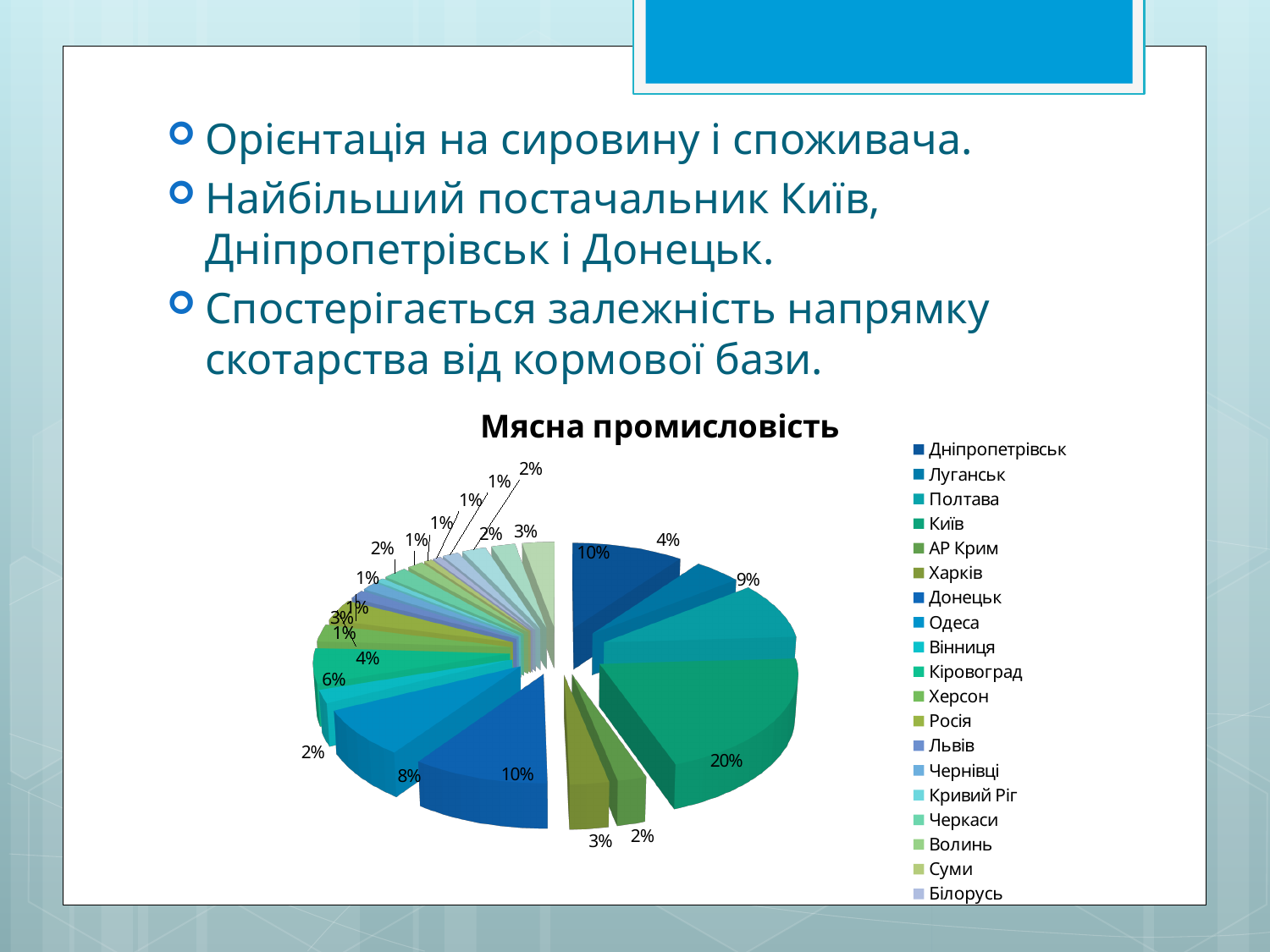
What kind of chart is shown on the slide? pie chart What is the largest share shown in the pie chart? 20% What is the title of the chart? Мясна промисловість What is the smallest share labelled on the pie chart? 1% What share does Дніпропетрівськ have in the pie chart? 10% Which is larger: the slice for Київ or the slice for Дніпропетрівськ? Київ Which legend entry is listed first in the chart legend? Дніпропетрівськ What is the difference between the Київ slice (20%) and the Дніпропетрівськ slice (10%)? 10% Which region has the largest slice in the pie chart? Київ What share does Київ have in the pie chart? 20%